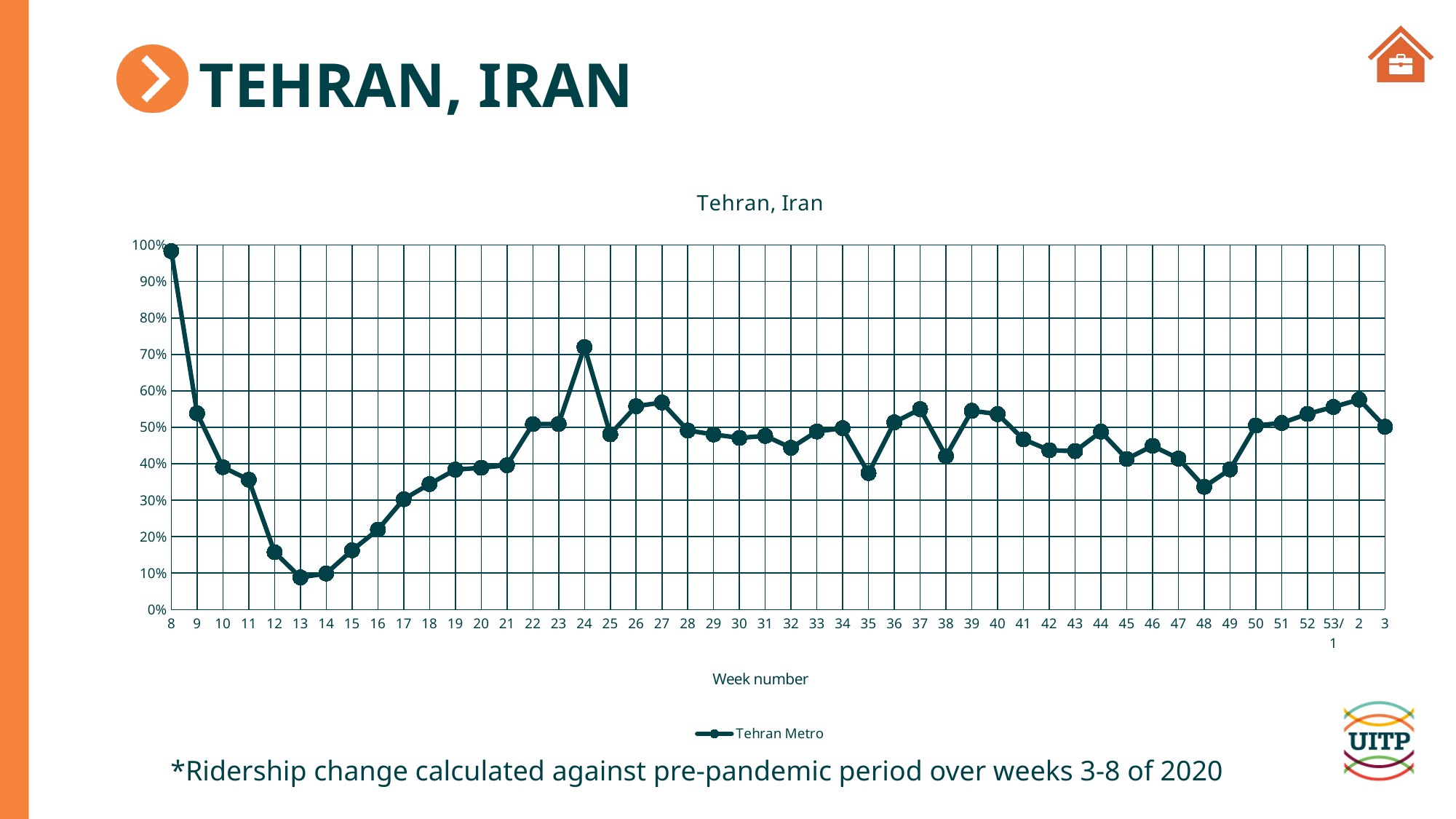
Is the value for week 24 greater or less than 60%? greater Is the value for week 13 greater or less than 20%? less Which has the larger value, week 13 or week 22? week 22 Is the value for week 2 greater or less than 50%? greater How many series does the legend list? 1 What is the name of the series shown in the legend? Tehran Metro What is the title of the x axis? Week number Which has the larger value, week 24 or week 25? week 24 What kind of chart is shown on the slide? line chart Which week has the highest value on the chart? 8 Do the values rise or fall from week 8 to week 13? fall